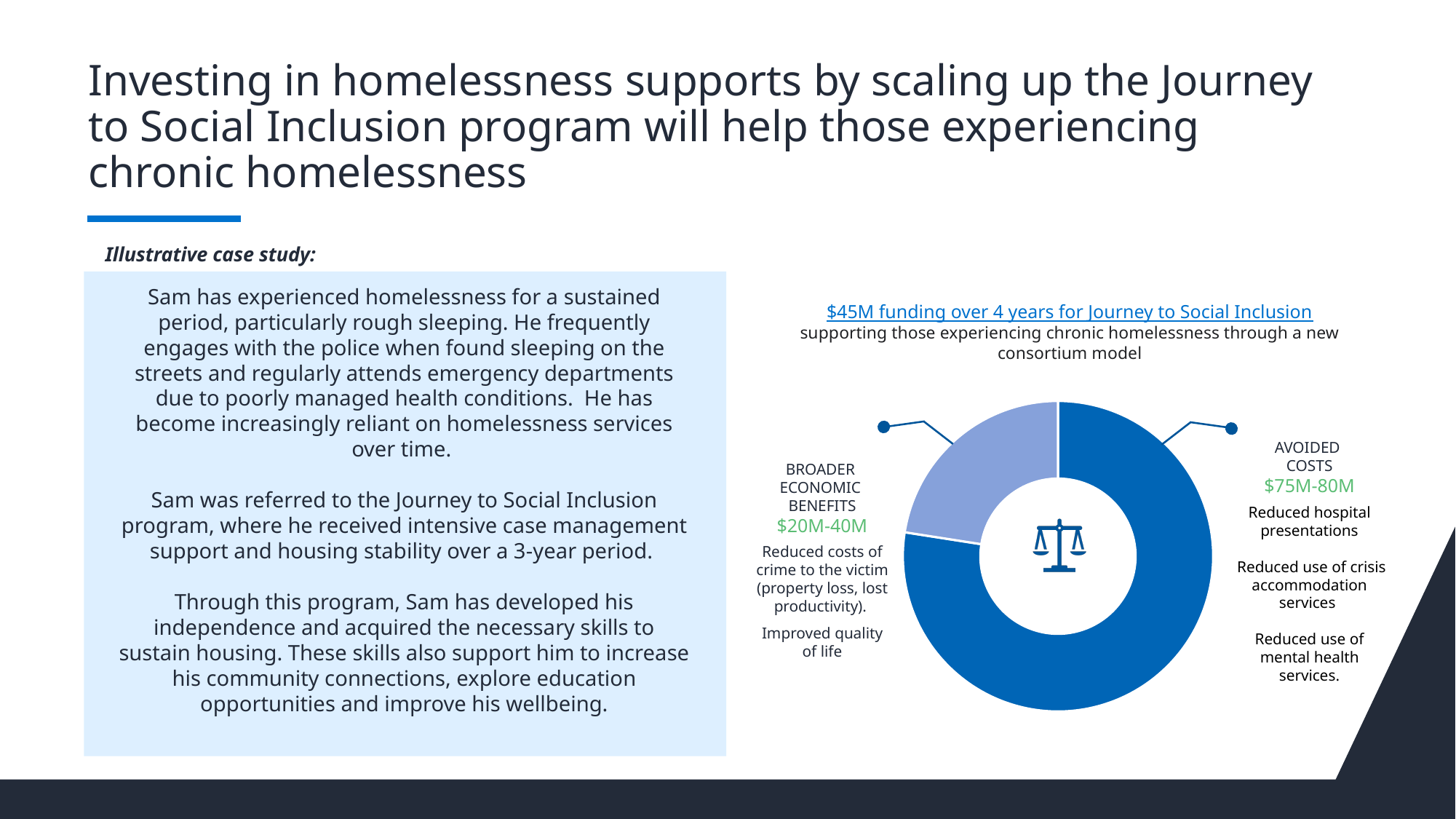
What kind of chart is shown on the right of the slide? Donut (pie) chart Does the Avoided Costs segment take up more or less than half of the donut chart? More Which is larger on the donut chart, Avoided Costs or Broader Economic Benefits? Avoided Costs What funding amount is stated in the heading above the donut chart? $45M funding over 4 years for Journey to Social Inclusion Which segment of the donut chart is shown in the lighter blue colour? Broader Economic Benefits Which segment of the donut chart is the largest? Avoided Costs Which segment of the donut chart is the smallest? Broader Economic Benefits How many segments does the donut chart have? 2 What value is shown for Broader Economic Benefits on the donut chart? $20M-40M What value is shown for Avoided Costs on the donut chart? $75M-80M